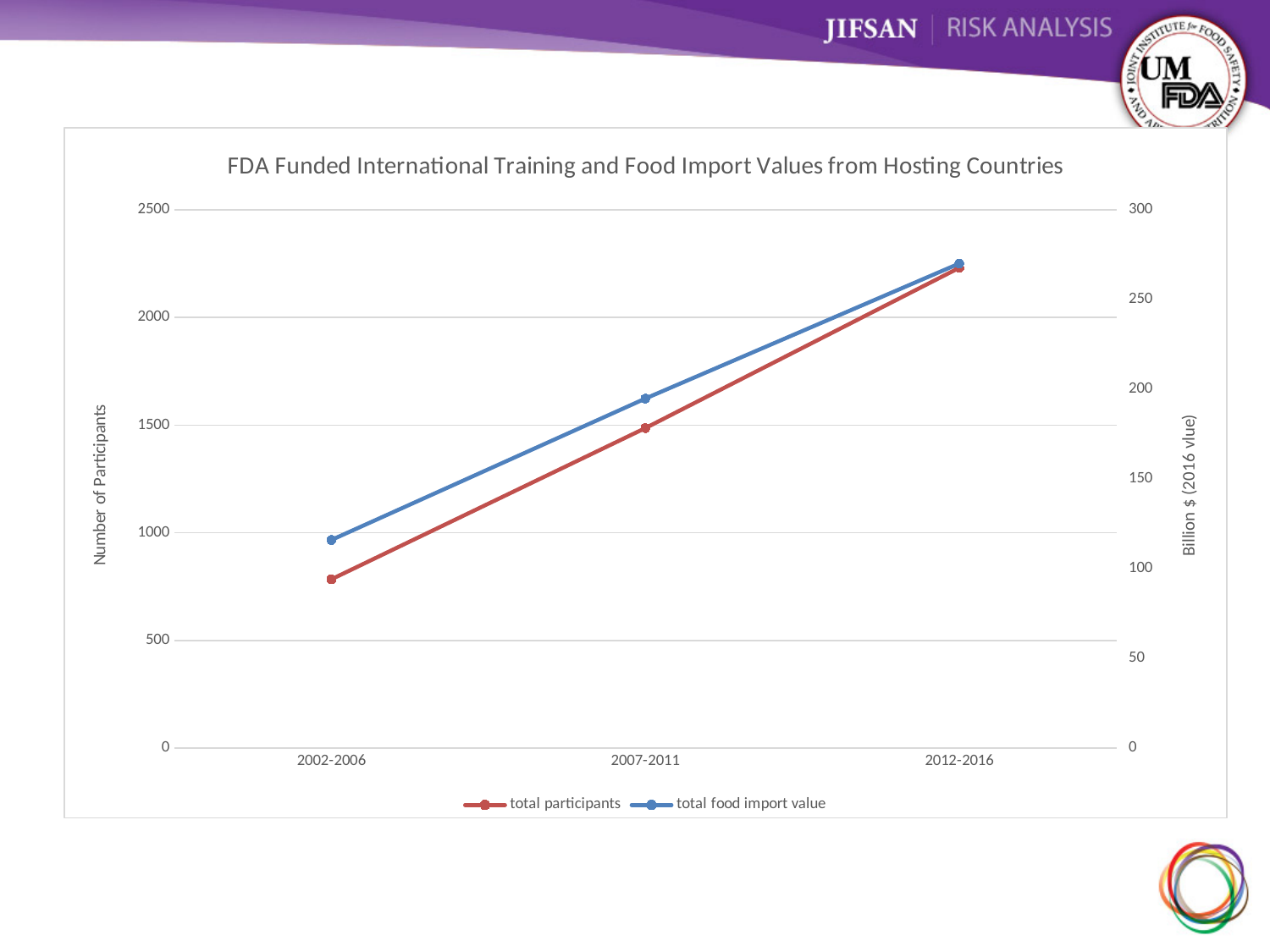
Do the total participants values rise or fall from 2002-2006 to 2012-2016? rise What is the title of the chart? FDA Funded International Training and Food Import Values from Hosting Countries In which period is the number of total participants highest? 2012-2016 In which period is the total food import value lowest? 2002-2006 How many time periods are plotted along the x axis? 3 What is the label of the right-hand vertical axis? Billion $ (2016 vlue) Is the value for total food import value in 2012-2016 greater or less than 250? greater Is the value for total participants in 2002-2006 greater or less than 1000? less How many series does the legend list? 2 Is the value for total participants in 2012-2016 greater or less than 2000? greater What kind of chart is shown on the slide? line chart Do the total food import value values rise or fall across the periods shown? rise